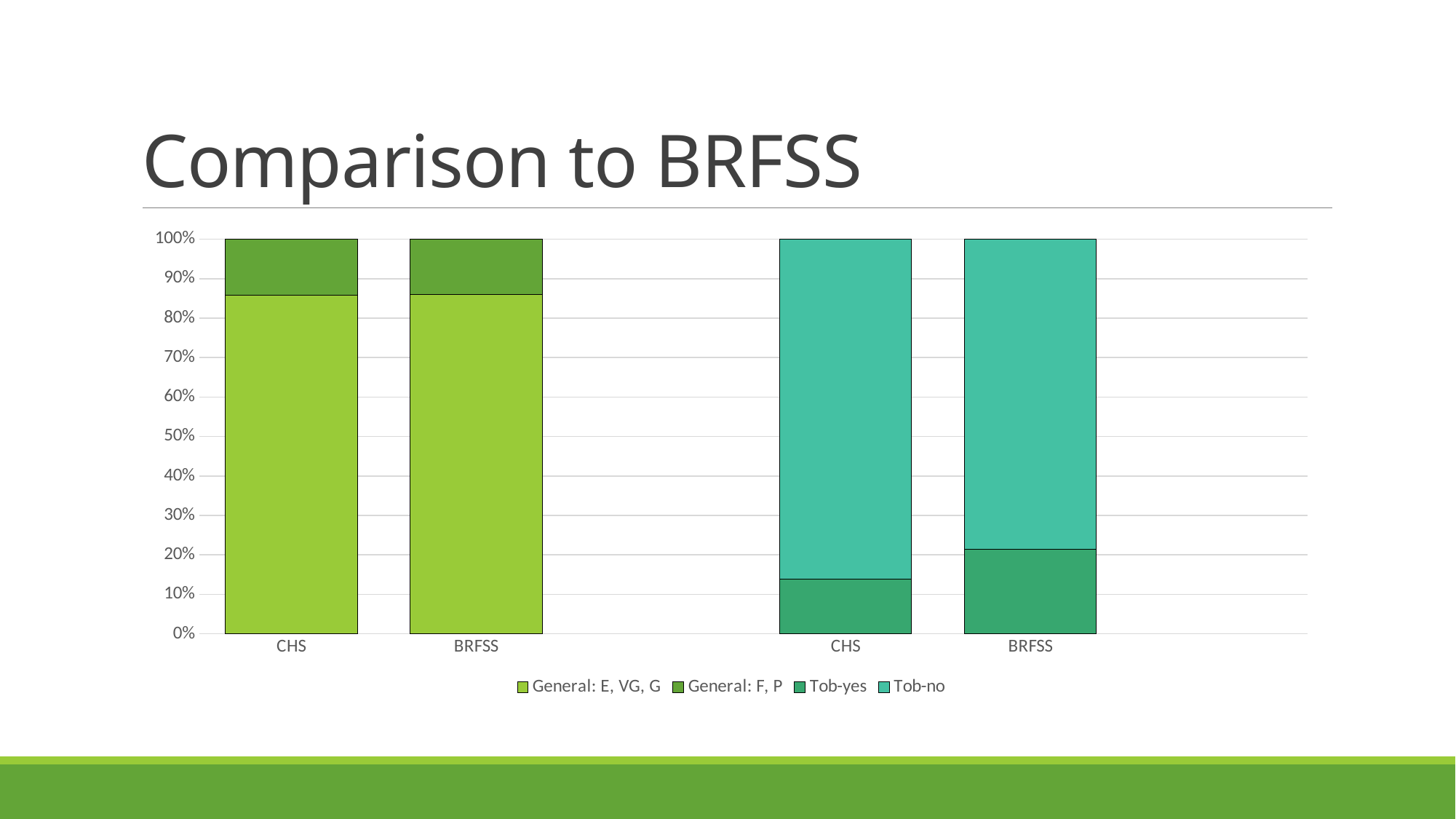
How many series does the legend list? 4 Is the Tob-yes value for BRFSS greater or less than 10%? greater Which has the larger Tob-yes share, CHS or BRFSS? BRFSS Is the Tob-yes value for CHS greater or less than 20%? less What is the total height of the CHS bar for the General health series? 100% What is the title of the slide containing the chart? Comparison to BRFSS Is the General: E, VG, G value for CHS greater or less than 80%? greater What kind of chart is shown on the slide? stacked bar chart How many bars are plotted in the chart? 4 Which legend entry is listed first? General: E, VG, G